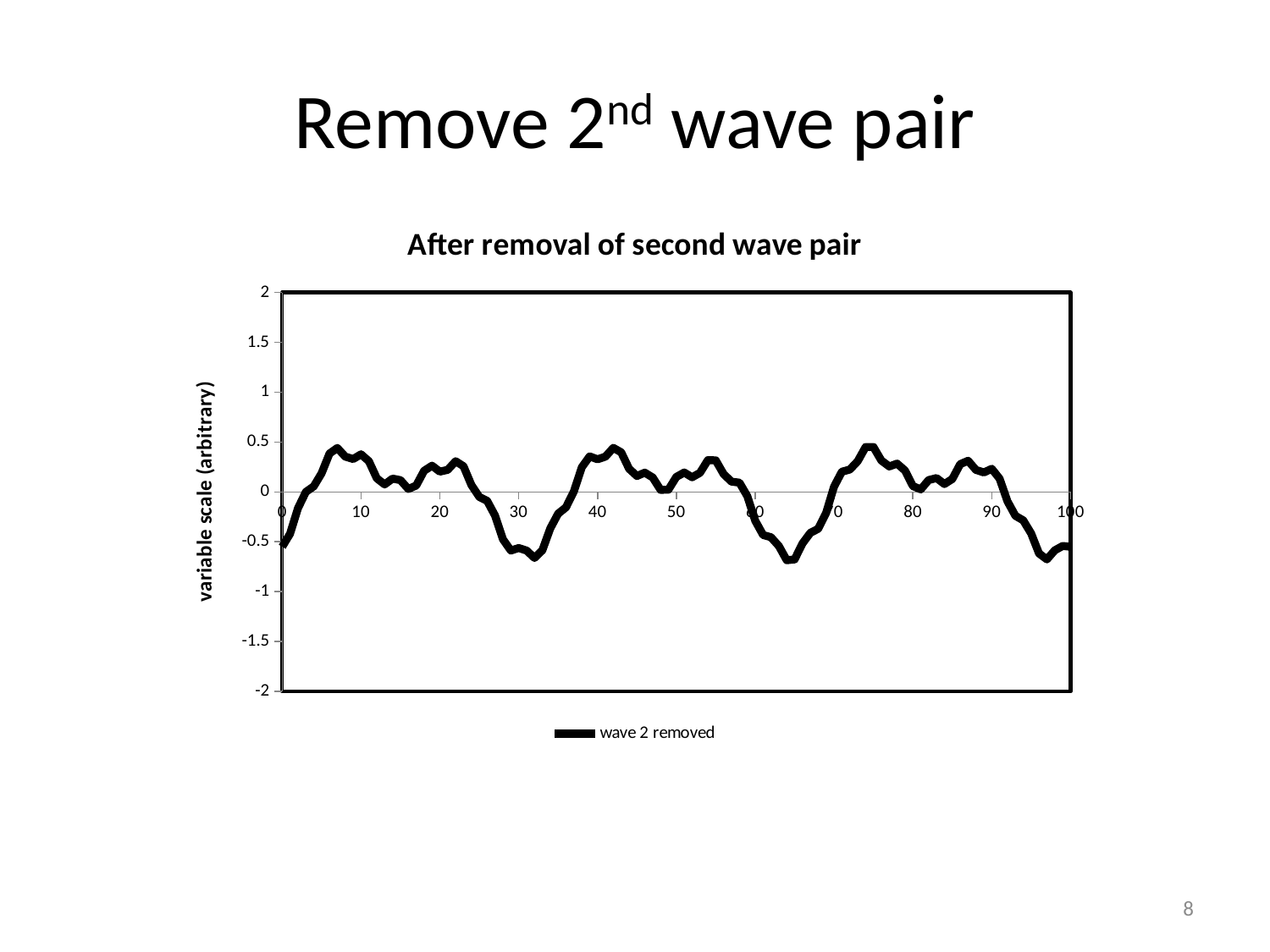
What kind of chart is shown on the slide? line chart How many series does the chart legend list? 1 Is the value of the line at x = 100 greater or less than 0? less Is the value of the line at x = 30 greater or less than 0? less What is the name of the series shown in the legend? wave 2 removed Is the value of the line at x = 0 greater or less than 0? less What is the title of the chart? After removal of second wave pair Between x = 20 and x = 30, does the line rise or fall? fall Between x = 0 and x = 10, does the line rise or fall? rise